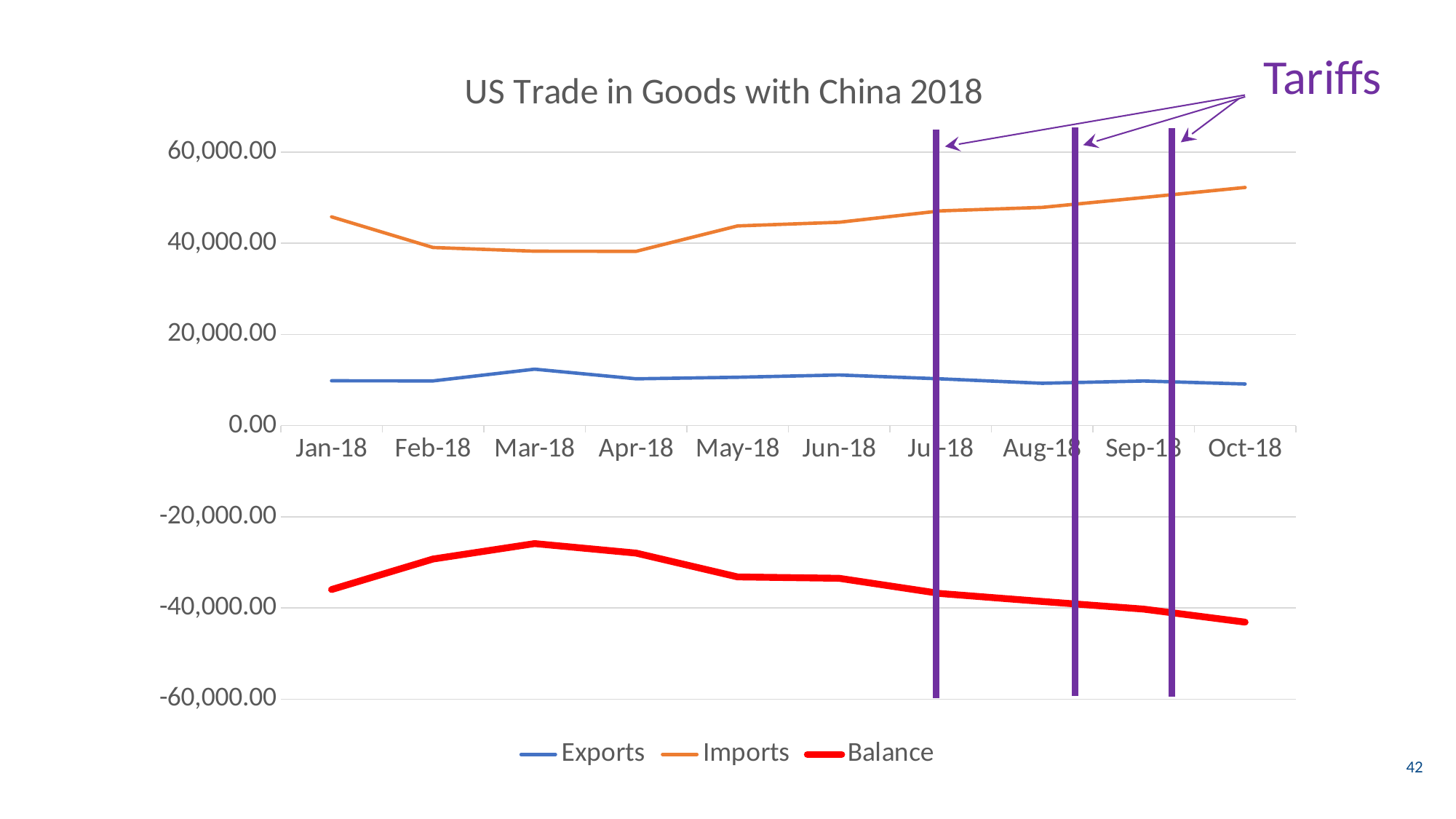
Which is larger in Jun-18, Imports or Exports? Imports Is the Imports value for Jan-18 greater or less than 40,000.00? greater Does the Imports line rise or fall from Apr-18 to Oct-18? rise How many months are plotted along the x axis? 10 How many series does the legend list? 3 Which series is drawn in red in the legend? Balance In which month is the Imports line at its highest? Oct-18 In which month is the Exports line at its highest? Mar-18 Is the Balance value for Oct-18 greater or less than -40,000.00? less What kind of chart is shown on the slide? line chart In which month is the Balance line at its lowest? Oct-18 What is the title of the chart? US Trade in Goods with China 2018